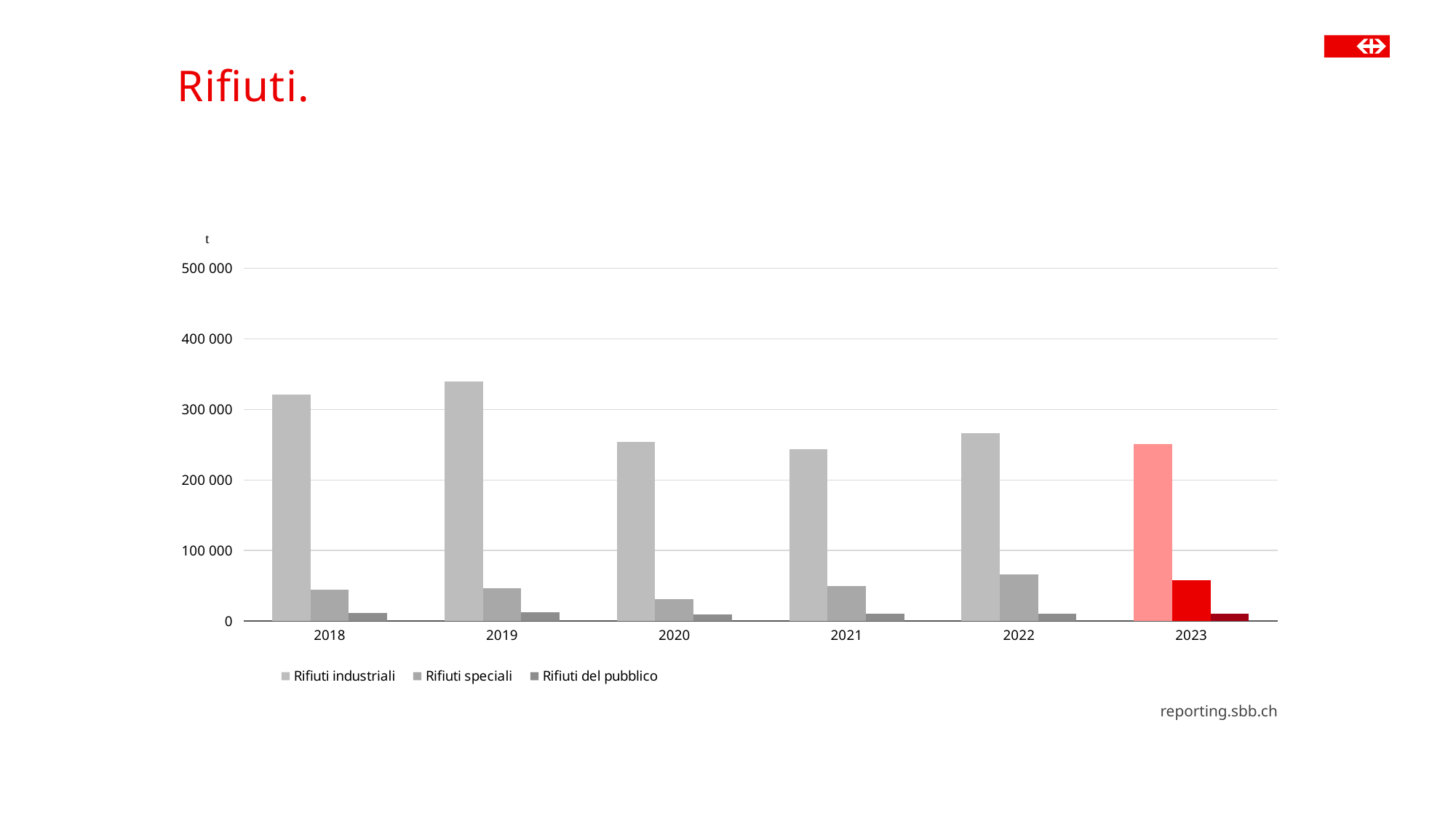
How many years are shown on the x axis? 6 In which year is the value for Rifiuti speciali highest? 2022 What kind of chart is shown on the slide? bar chart Is the value for Rifiuti industriali in 2021 greater or less than 300 000? less Is the value for Rifiuti speciali in 2022 greater or less than 100 000? less Which is larger, Rifiuti industriali in 2018 or Rifiuti industriali in 2020? 2018 Is the value for Rifiuti industriali in 2019 greater or less than 300 000? greater In which year is the value for Rifiuti speciali lowest? 2020 How many series does the legend list? 3 Which series has the smallest bars in every year? Rifiuti del pubblico What unit is shown at the top of the y axis? t In which year is the value for Rifiuti industriali highest? 2019